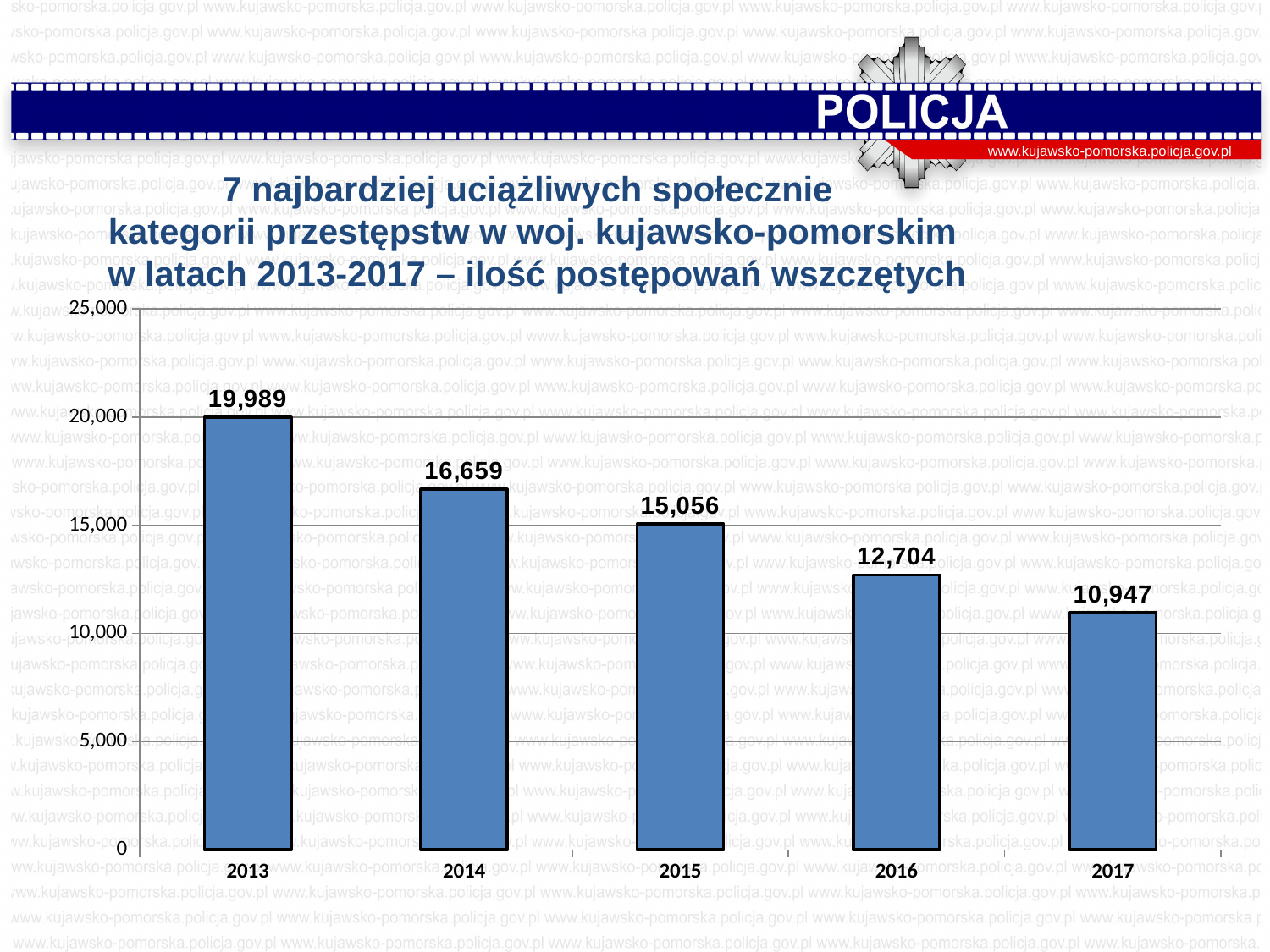
Is the value for 2016 greater or less than 15,000? less What was the number of proceedings initiated in 2013? 19,989 Which year has the lowest value? 2017 What was the number of proceedings initiated in 2015? 15,056 Do the values rise or fall from 2013 to 2017? fall What is the difference between the values for 2013 and 2017? 9,042 Which year has the highest value? 2013 Which is larger, the value for 2016 or the value for 2017? 2016 What was the number of proceedings initiated in 2017? 10,947 What kind of chart is shown on the slide? bar chart How many years are shown on the x axis? 5 What is the difference between the values for 2014 and 2015? 1,603